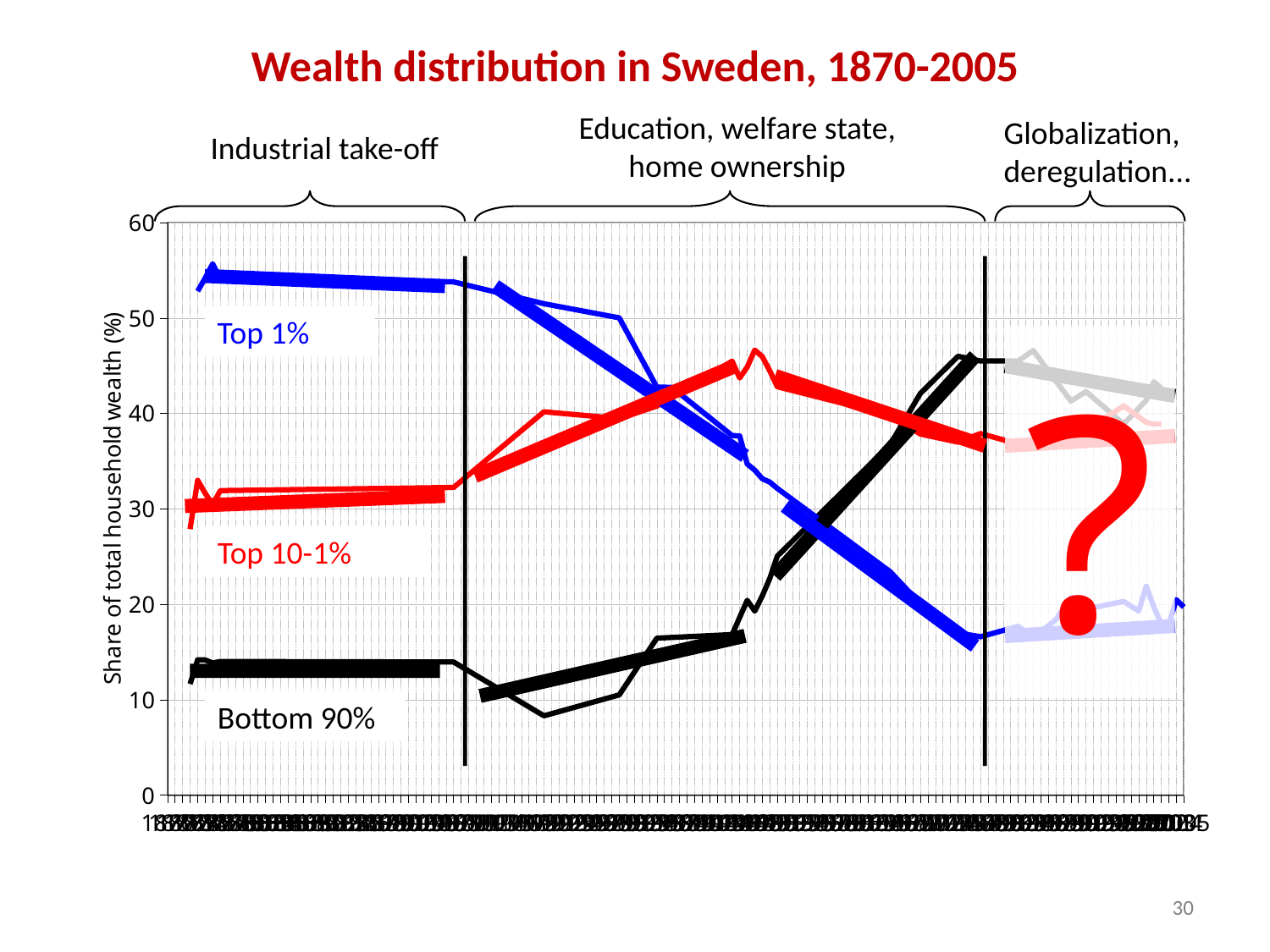
At the left edge of the chart, is the value for Top 1% greater or less than 50? greater What is the title of the chart? Wealth distribution in Sweden, 1870-2005 At the right-hand vertical line (end of the 'Education, welfare state, home ownership' period), which is higher, Top 1% or Bottom 90%? Bottom 90% At the left edge of the chart, is the value for Top 10-1% greater or less than 40? less What is the label of the vertical axis? Share of total household wealth (%) Does the Bottom 90% series rise or fall overall from the left of the chart to the right? rise At the left edge of the chart, which series has the highest value? Top 1% What kind of chart is shown on the slide? line chart At the right-hand vertical line (end of the 'Education, welfare state, home ownership' period), is the value for Top 1% greater or less than 20? less How many data series are labelled on the chart? 3 Does the Top 1% series rise or fall overall from the left of the chart to the right? fall